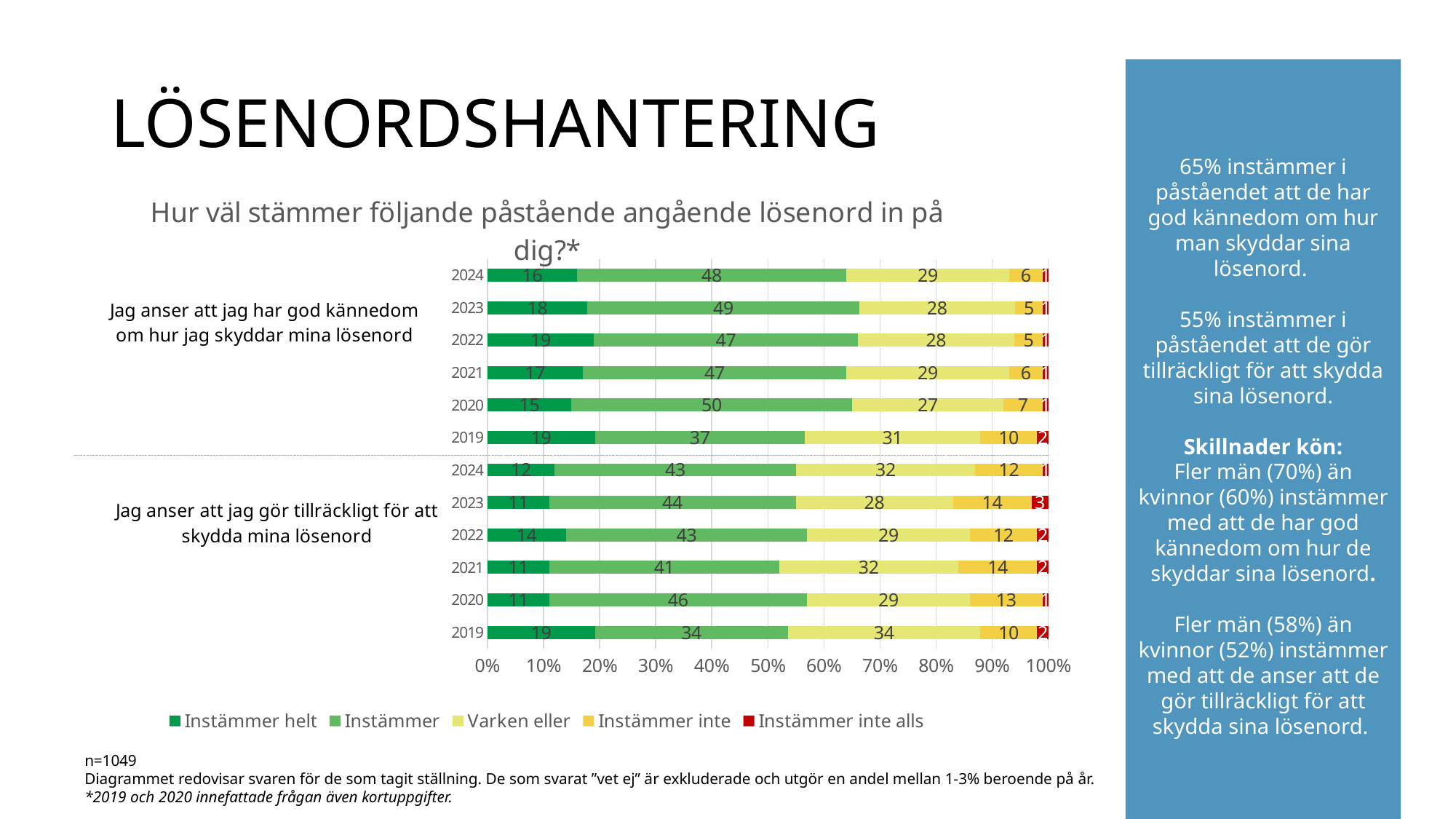
For 2024, which statement has the larger 'Varken eller' value: 'Jag anser att jag har god kännedom om hur jag skyddar mina lösenord' or 'Jag anser att jag gör tillräckligt för att skydda mina lösenord'? Jag anser att jag gör tillräckligt för att skydda mina lösenord What kind of chart is shown on the slide? Stacked bar chart How many years are shown for each statement in the chart? 6 For the statement 'Jag anser att jag har god kännedom om hur jag skyddar mina lösenord', what is the difference between the 'Instämmer helt' values for 2019 and 2024? 3 What is the first entry in the chart's legend? Instämmer helt For the statement 'Jag anser att jag gör tillräckligt för att skydda mina lösenord', what is the difference between the 'Instämmer inte' values for 2024 and 2019? 2 For the statement 'Jag anser att jag har god kännedom om hur jag skyddar mina lösenord', which year has the lowest 'Instämmer' value? 2019 How many series does the legend list? 5 For the statement 'Jag anser att jag gör tillräckligt för att skydda mina lösenord', what is the 'Varken eller' value for 2019? 34 For the statement 'Jag anser att jag har god kännedom om hur jag skyddar mina lösenord', which year has the highest 'Instämmer' value? 2020 For the statement 'Jag anser att jag har god kännedom om hur jag skyddar mina lösenord', what is the 'Instämmer' value for 2024? 48 For the statement 'Jag anser att jag gör tillräckligt för att skydda mina lösenord', what is the 'Instämmer inte' value for 2023? 14